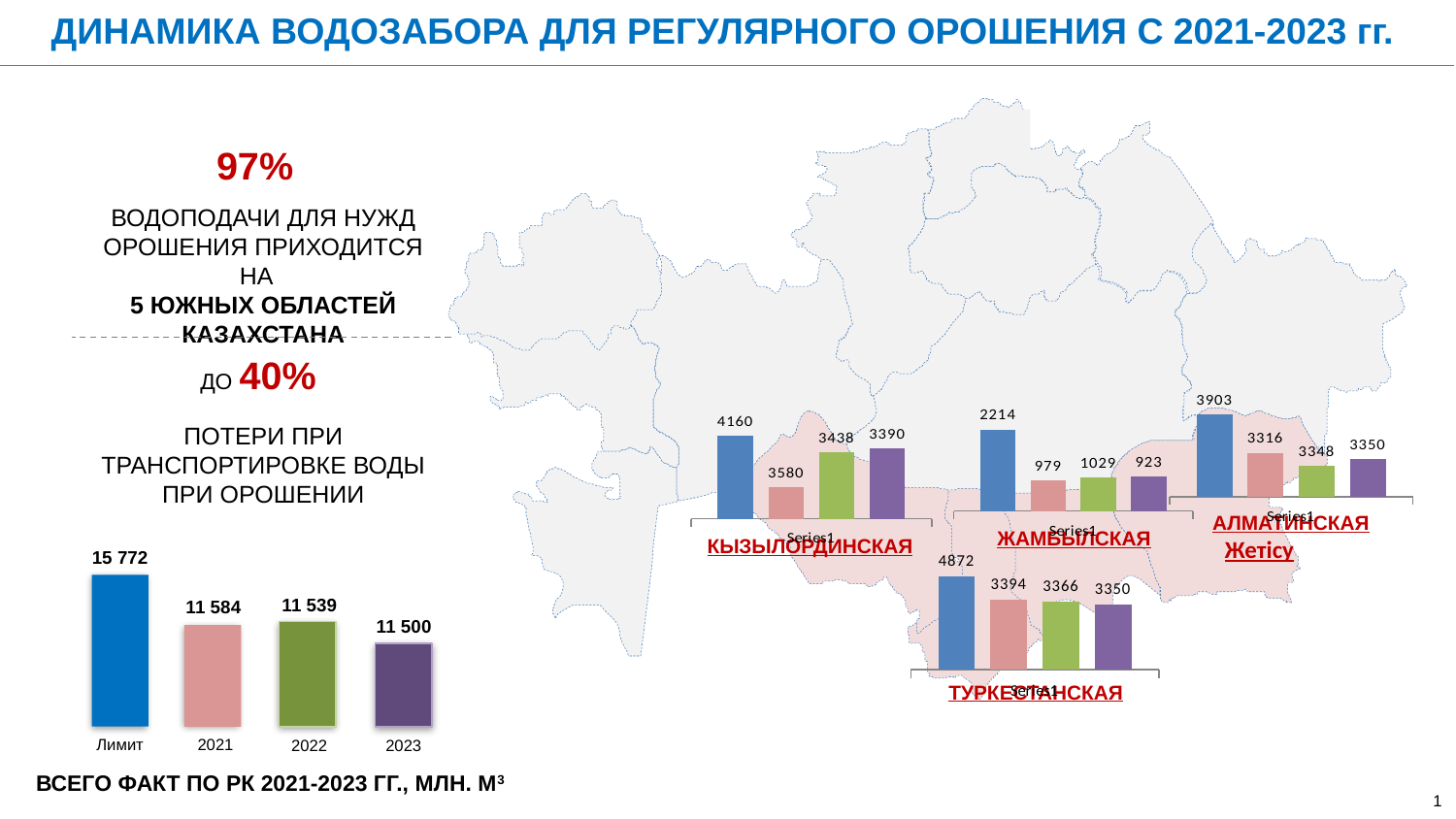
In the bottom-left chart 'ВСЕГО ФАКТ ПО РК 2021-2023 ГГ., МЛН. М³', what is the difference between the values for 2021 and 2022? 45 In the bottom-left chart 'ВСЕГО ФАКТ ПО РК 2021-2023 ГГ., МЛН. М³', what is the value for Лимит? 15 772 In the chart labelled ЖАМБЫЛСКАЯ on the map, what is the value of the last (purple) bar? 923 In the bottom-left chart 'ВСЕГО ФАКТ ПО РК 2021-2023 ГГ., МЛН. М³', do the values rise or fall from 2021 to 2023? fall In the chart labelled КЫЗЫЛОРДИНСКАЯ on the map, what is the difference between the first (blue) bar and the second (pink) bar? 580 What kind of chart is the bottom-left chart 'ВСЕГО ФАКТ ПО РК 2021-2023 ГГ., МЛН. М³'? bar chart In the bottom-left chart 'ВСЕГО ФАКТ ПО РК 2021-2023 ГГ., МЛН. М³', which category has the lowest value? 2023 In the bottom-left chart 'ВСЕГО ФАКТ ПО РК 2021-2023 ГГ., МЛН. М³', what is the value for 2023? 11 500 Which is larger: the first (blue) bar in the ТУРКЕСТАНСКАЯ chart or the first (blue) bar in the АЛМАТИНСКАЯ Жетісу chart? ТУРКЕСТАНСКАЯ In the bottom-left chart 'ВСЕГО ФАКТ ПО РК 2021-2023 ГГ., МЛН. М³', which category has the highest value? Лимит In the chart labelled ТУРКЕСТАНСКАЯ on the map, what is the value of the first (blue) bar? 4872 In the bottom-left chart 'ВСЕГО ФАКТ ПО РК 2021-2023 ГГ., МЛН. М³', how many bars are there? 4